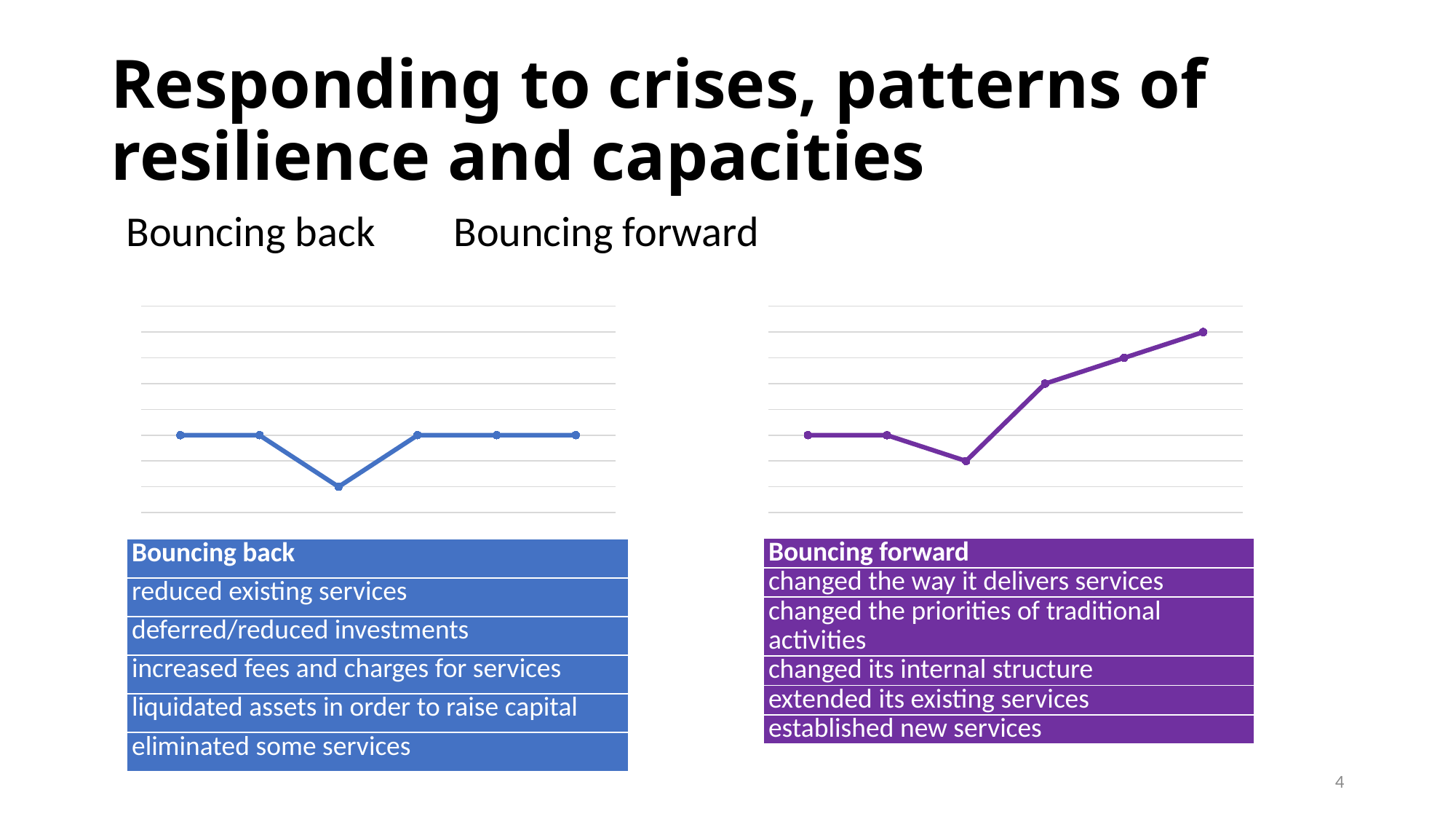
What kind of chart is the Bouncing back chart on the left? line chart What colour is the line on the Bouncing back chart? blue On the Bouncing back chart, does the line end higher, lower, or at the same level as it starts? same level On the Bouncing forward chart, is the last point higher or lower than the first point? higher On the Bouncing forward chart, which point is the lowest? the third point How many data points are plotted on the Bouncing forward chart? 6 What kind of chart is the Bouncing forward chart on the right? line chart On the Bouncing back chart, which point is the lowest? the third point How many data points are plotted on the Bouncing back chart? 6 On the Bouncing forward chart, does the line overall rise or fall from left to right? rise What colour is the line on the Bouncing forward chart? purple On the Bouncing forward chart, which point is the highest? the sixth (last) point